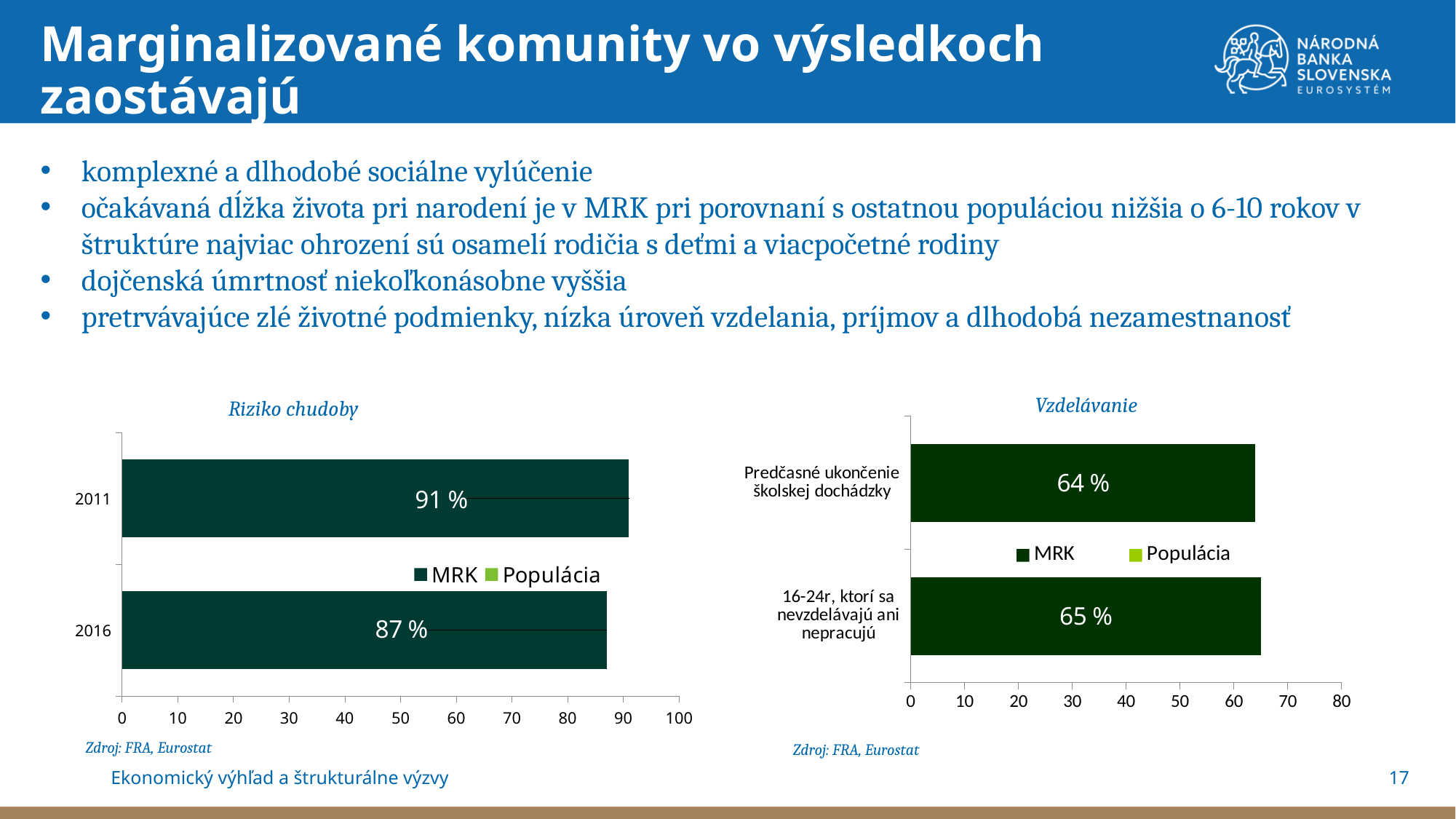
In the 'Riziko chudoby' chart, what is the highest value shown on the x axis? 100 In the 'Riziko chudoby' chart, which year has the higher MRK value? 2011 What kind of chart is the 'Vzdelávanie' chart? Bar chart In the 'Riziko chudoby' chart, what is the MRK value for 2011? 91 % In the 'Vzdelávanie' chart, what is the value for '16-24r, ktorí sa nevzdelávajú ani nepracujú'? 65 % In the 'Riziko chudoby' chart, what is the MRK value for 2016? 87 % In the 'Vzdelávanie' chart, what is the value for 'Predčasné ukončenie školskej dochádzky'? 64 % In the 'Riziko chudoby' chart, what is the difference between the 2011 and 2016 MRK values? 4 % In the 'Riziko chudoby' chart, how many series does the legend list? 2 In the 'Vzdelávanie' chart, what is the difference between the two plotted values? 1 % In the 'Vzdelávanie' chart, what are the two legend entries? MRK and Populácia In the 'Vzdelávanie' chart, how many categories are shown? 2